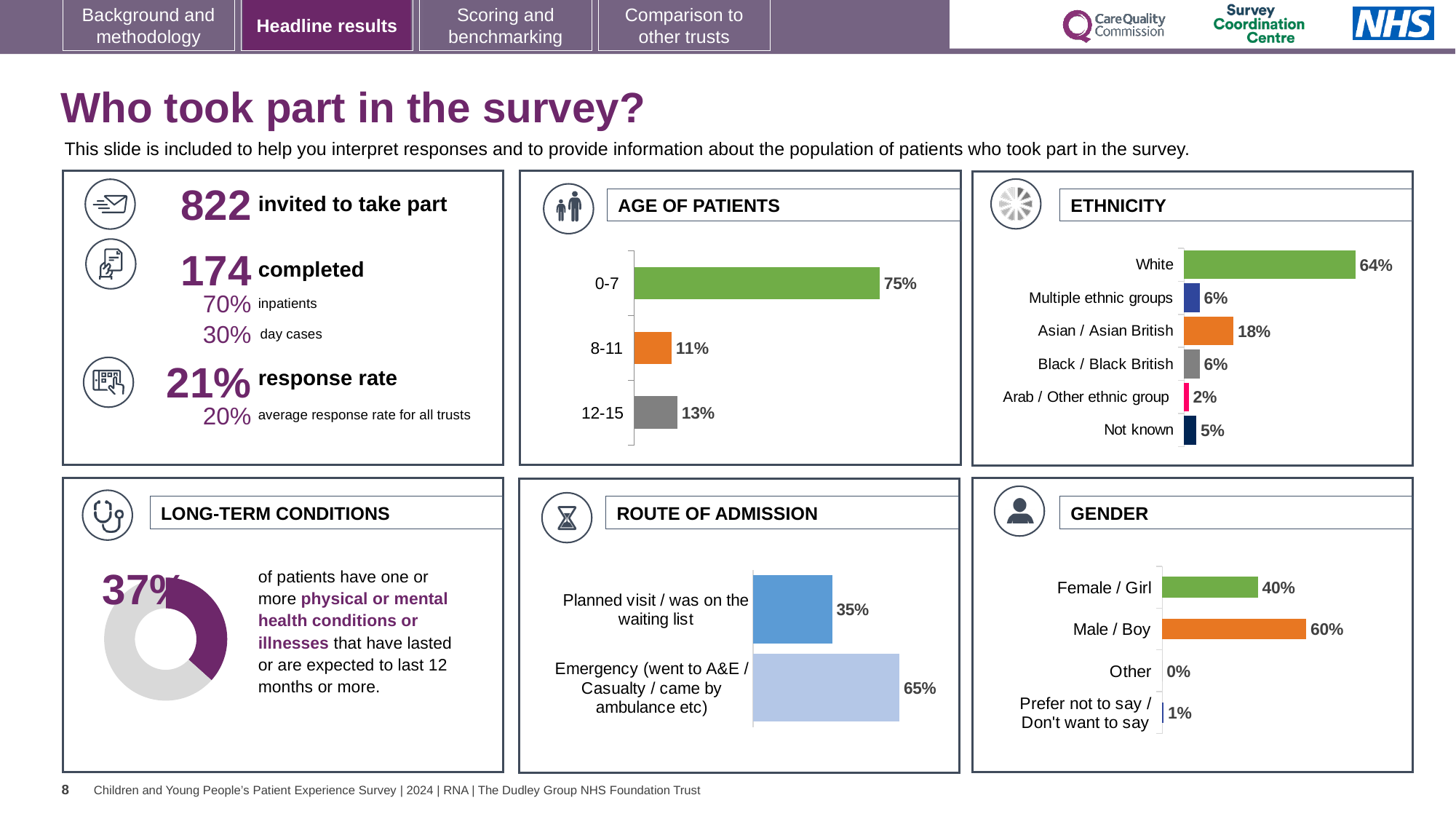
In the GENDER chart, what percentage of patients are Male / Boy? 60% What kind of chart is used in the LONG-TERM CONDITIONS panel? Doughnut chart In the ETHNICITY chart, what is the difference between the White and Asian / Asian British percentages? 46% In the GENDER chart, what is the difference between the Male / Boy and Female / Girl percentages? 20% In the AGE OF PATIENTS chart, which age group has the lowest percentage? 8-11 In the ROUTE OF ADMISSION chart, what percentage of patients came via Emergency (went to A&E / Casualty / came by ambulance etc)? 65% In the ROUTE OF ADMISSION chart, which route has the larger percentage: Planned visit / was on the waiting list or Emergency? Emergency (went to A&E / Casualty / came by ambulance etc) In the AGE OF PATIENTS chart, what percentage of patients are aged 0-7? 75% In the ETHNICITY chart, which category has the highest percentage? White In the ETHNICITY chart, what percentage of patients are Asian / Asian British? 18% In the ETHNICITY chart, how many ethnicity categories are shown? 6 In the AGE OF PATIENTS chart, how many age groups are shown? 3